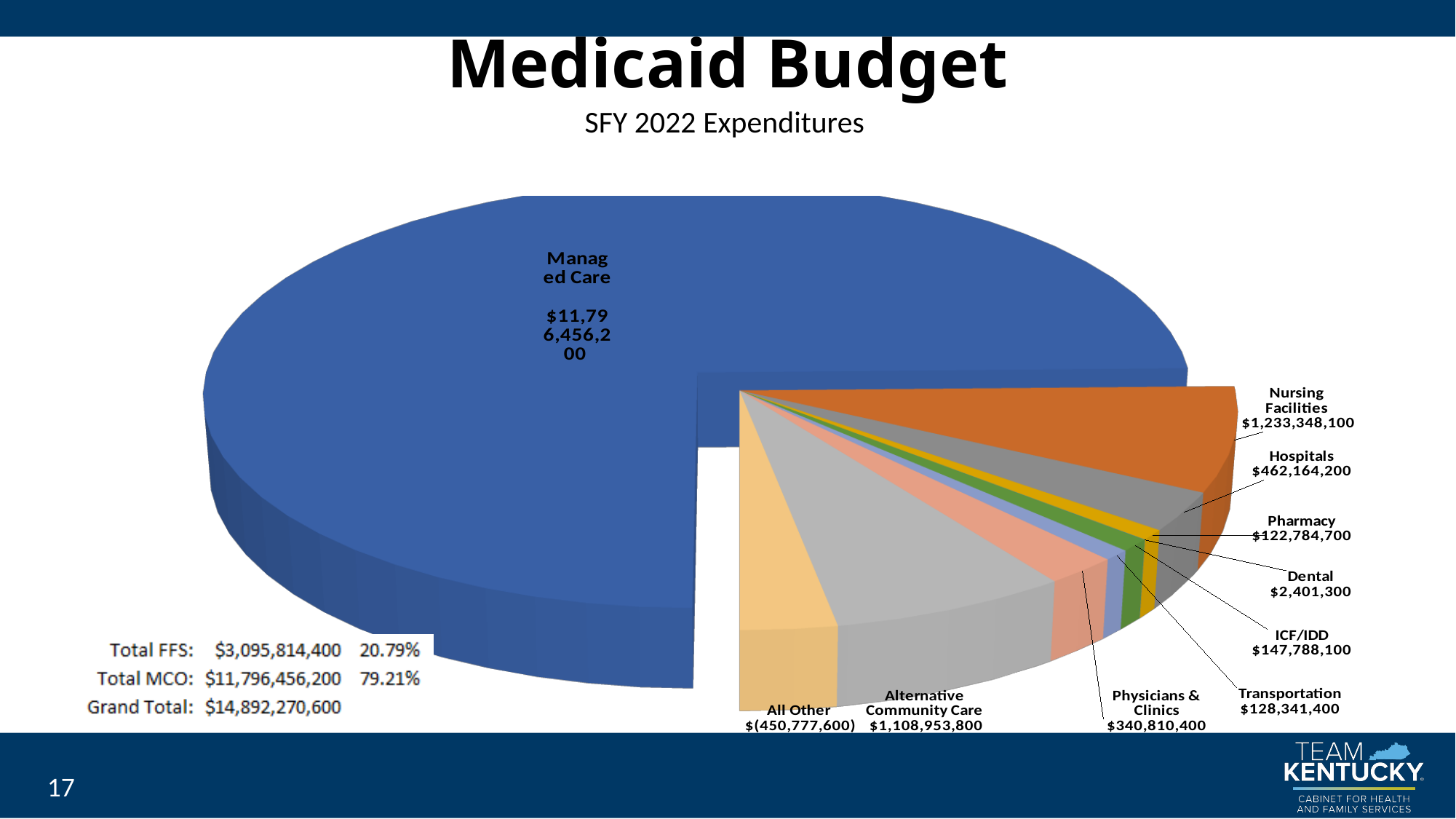
How many categories are labeled on the pie chart? 10 Which category has the largest slice of the pie chart? Managed Care What is the difference between the Nursing Facilities value and the Hospitals value? $771,183,900 What kind of chart is shown on the slide? Pie chart What is the Grand Total shown on the slide? $14,892,270,600 What is the difference between the ICF/IDD value and the Transportation value? $19,446,700 What is the value shown for Managed Care on the pie chart? $11,796,456,200 What is the value shown for Hospitals? $462,164,200 What is the value shown for Alternative Community Care? $1,108,953,800 What is the value shown for Dental? $2,401,300 Which is larger, Nursing Facilities or Alternative Community Care? Nursing Facilities What is the value shown for Nursing Facilities? $1,233,348,100